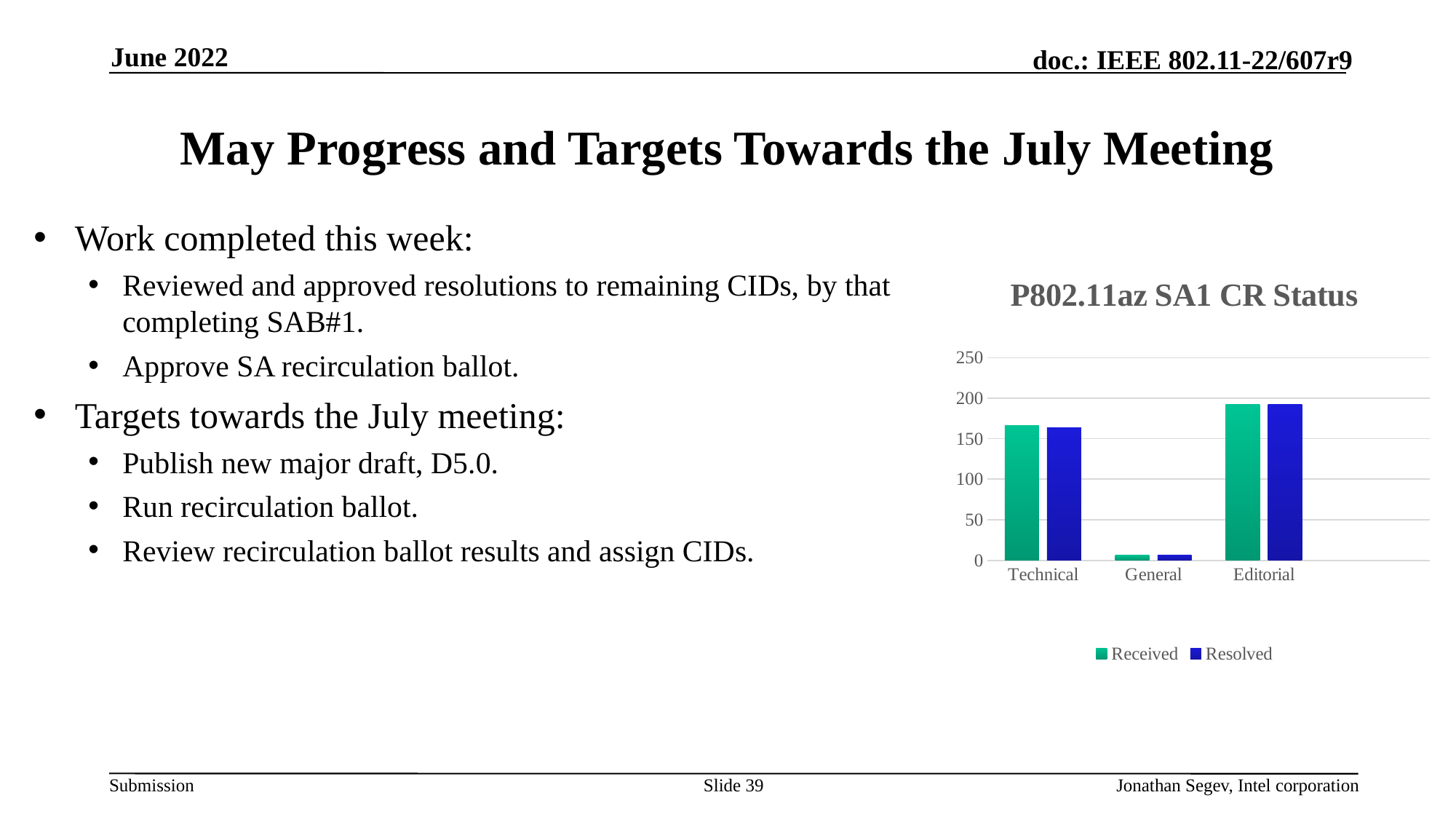
Which category has the lowest Resolved value? General Which series are listed in the chart legend? Received and Resolved Which category has the lowest Received value? General What kind of chart is shown on the slide? bar chart Is the Resolved value for Editorial greater or less than 200? less What is the title of the chart? P802.11az SA1 CR Status How many series does the chart legend list? 2 Is the Received value for General greater or less than 50? less Which is larger, the Received value for Technical or the Received value for Editorial? Editorial Is the Received value for Technical greater or less than 150? greater Which category has the highest Received value? Editorial How many categories are shown on the x axis of the chart? 3